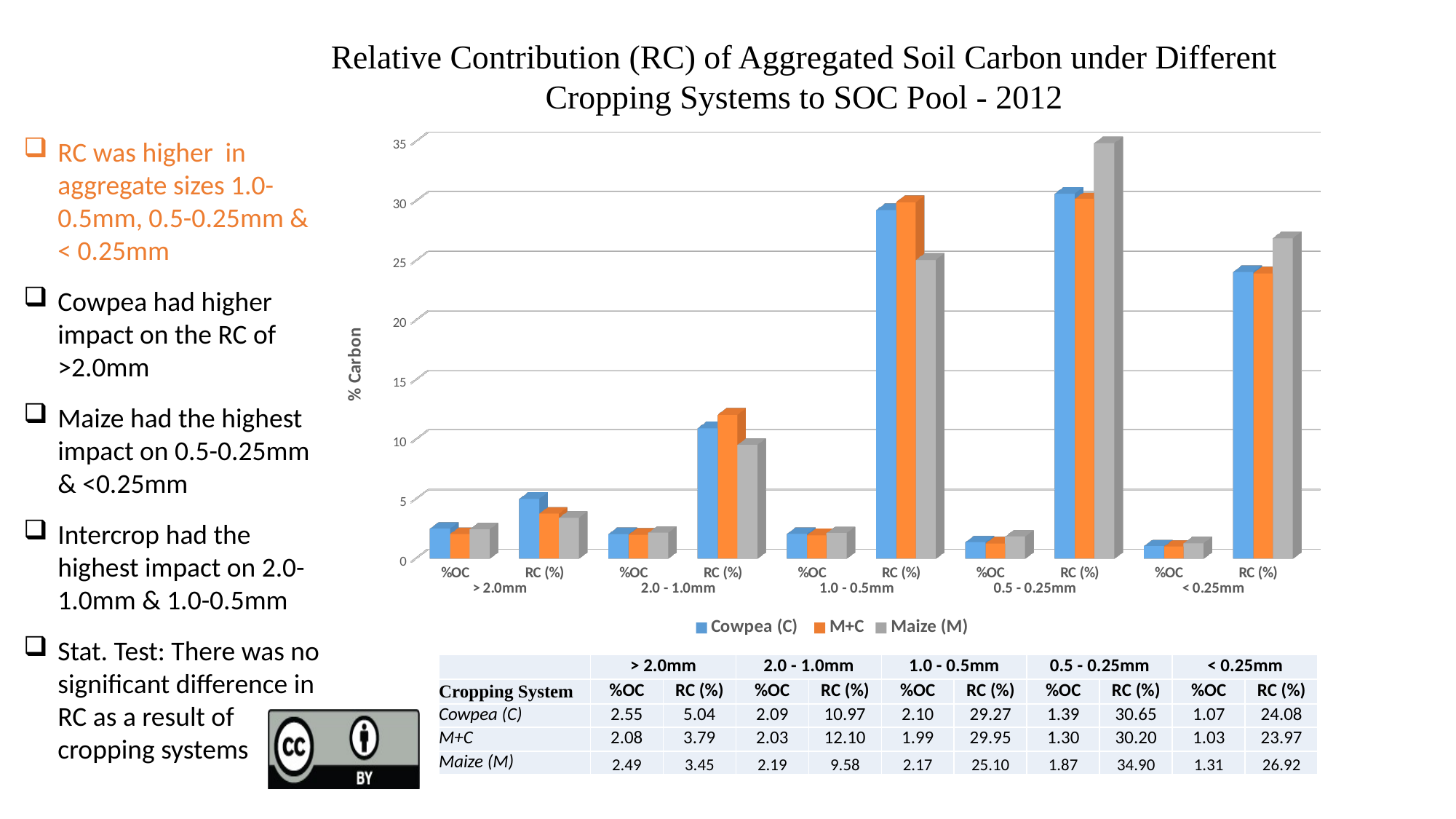
What is the RC (%) value for Cowpea (C) in the 1.0 - 0.5mm aggregate size? 29.27 Which cropping system has the highest RC (%) in the 2.0 - 1.0mm aggregate size? M+C What is the RC (%) value for Maize (M) in the 0.5 - 0.25mm aggregate size? 34.90 What is the label on the vertical axis of the chart? % Carbon What kind of chart is shown on the slide? bar chart Which cropping system has the highest RC (%) in the 0.5 - 0.25mm aggregate size? Maize (M) How many series does the chart legend list? 3 Which cropping system has the lowest RC (%) in the 1.0 - 0.5mm aggregate size? Maize (M) Which is larger in the > 2.0mm aggregate size: the RC (%) for Cowpea (C) or for Maize (M)? Cowpea (C) Is the RC (%) value for Maize (M) in the < 0.25mm aggregate size greater or less than 25? greater What is the %OC value for M+C in the > 2.0mm aggregate size? 2.08 What is the difference between the RC (%) of Maize (M) and Cowpea (C) in the 0.5 - 0.25mm aggregate size? 4.25